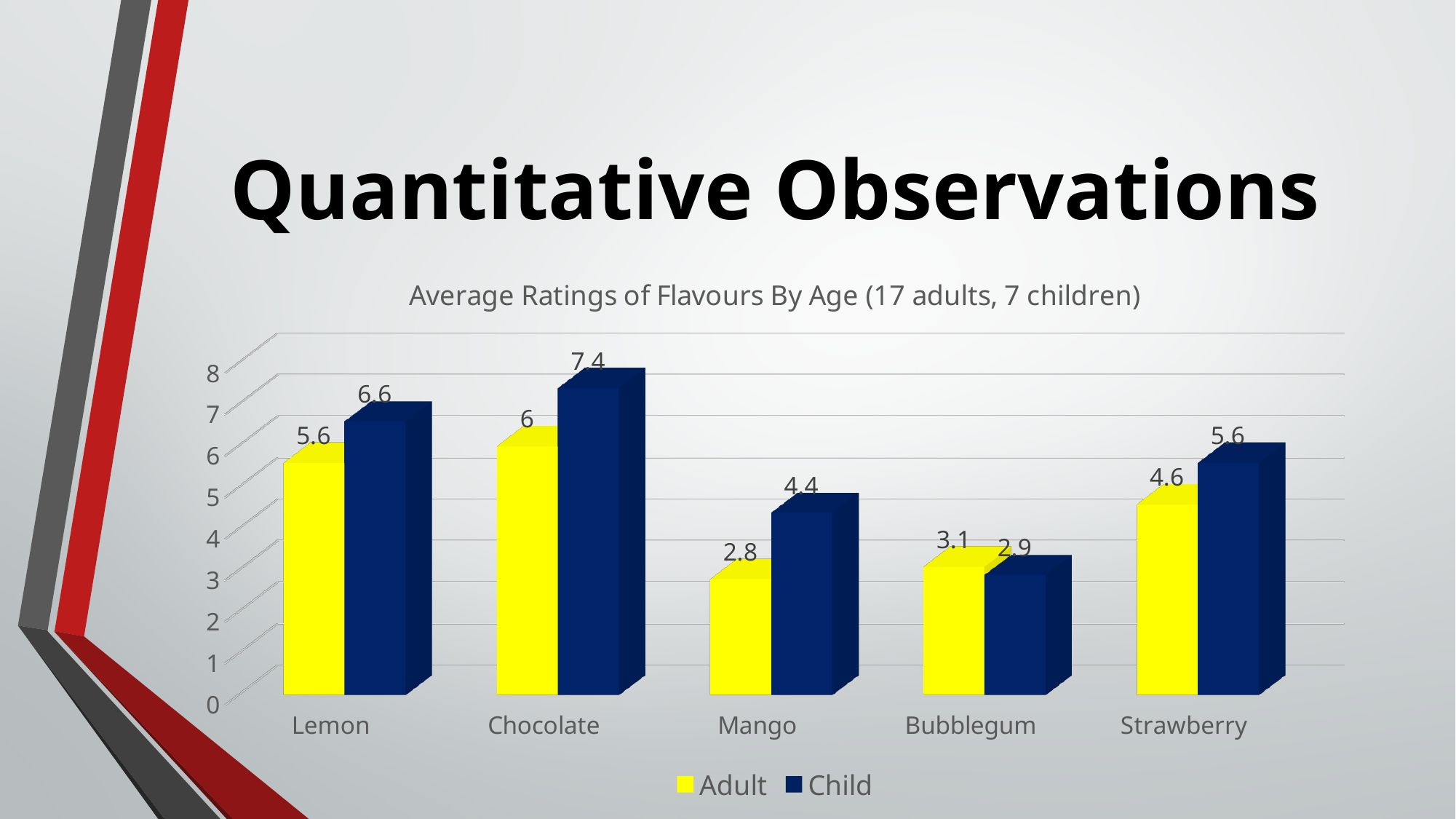
Which flavour has the highest Child rating? Chocolate What is the Child rating for Chocolate? 7.4 What kind of chart is shown on the slide? Bar chart What is the Child rating for Mango? 4.4 What is the Adult rating for Lemon? 5.6 How many flavours are shown on the x axis? 5 Which is larger for Bubblegum, the Adult rating or the Child rating? Adult Which flavour has the lowest Adult rating? Mango Is the Adult rating for Strawberry greater or less than 4? greater What is the difference between the Child and Adult ratings for Mango? 1.6 How many series does the legend list? 2 What is the title of the chart? Average Ratings of Flavours By Age (17 adults, 7 children)